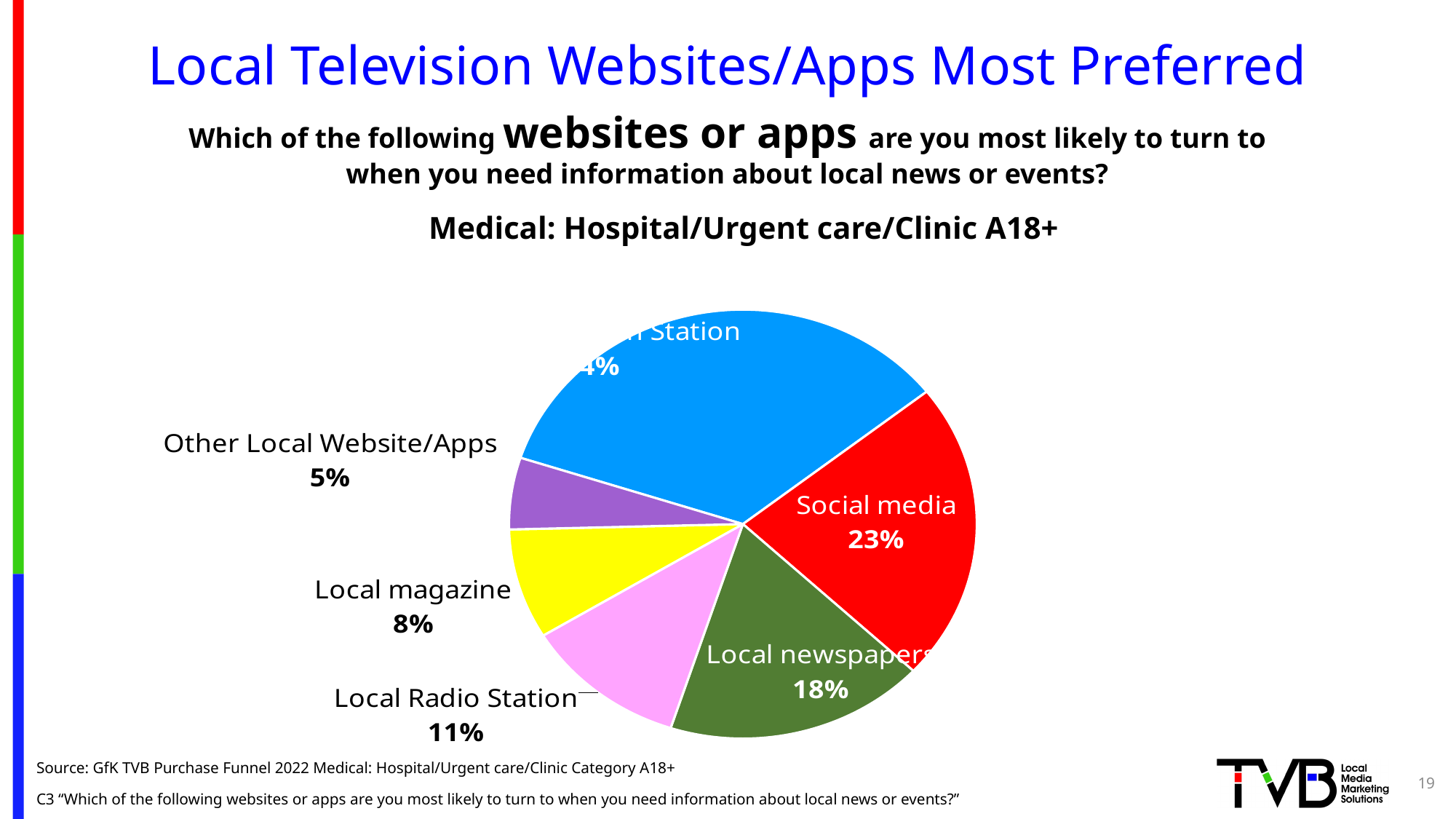
What percentage is shown for Local magazine? 8% What is the difference between Local Radio Station and Other Local Website/Apps? 6% Which is larger, Local Radio Station or Local magazine? Local Radio Station What is the value for Local Radio Station? 11% What is the value for Other Local Website/Apps? 5% What is the difference between the Social media and Local newspapers percentages? 5% What colour is the Social media slice? Red Which category has the smallest share of the pie? Other Local Website/Apps What percentage is shown for Local newspapers? 18% What type of chart is shown on the slide? Pie chart How many slices does the pie chart have? 6 What percentage of respondents chose Social media? 23%